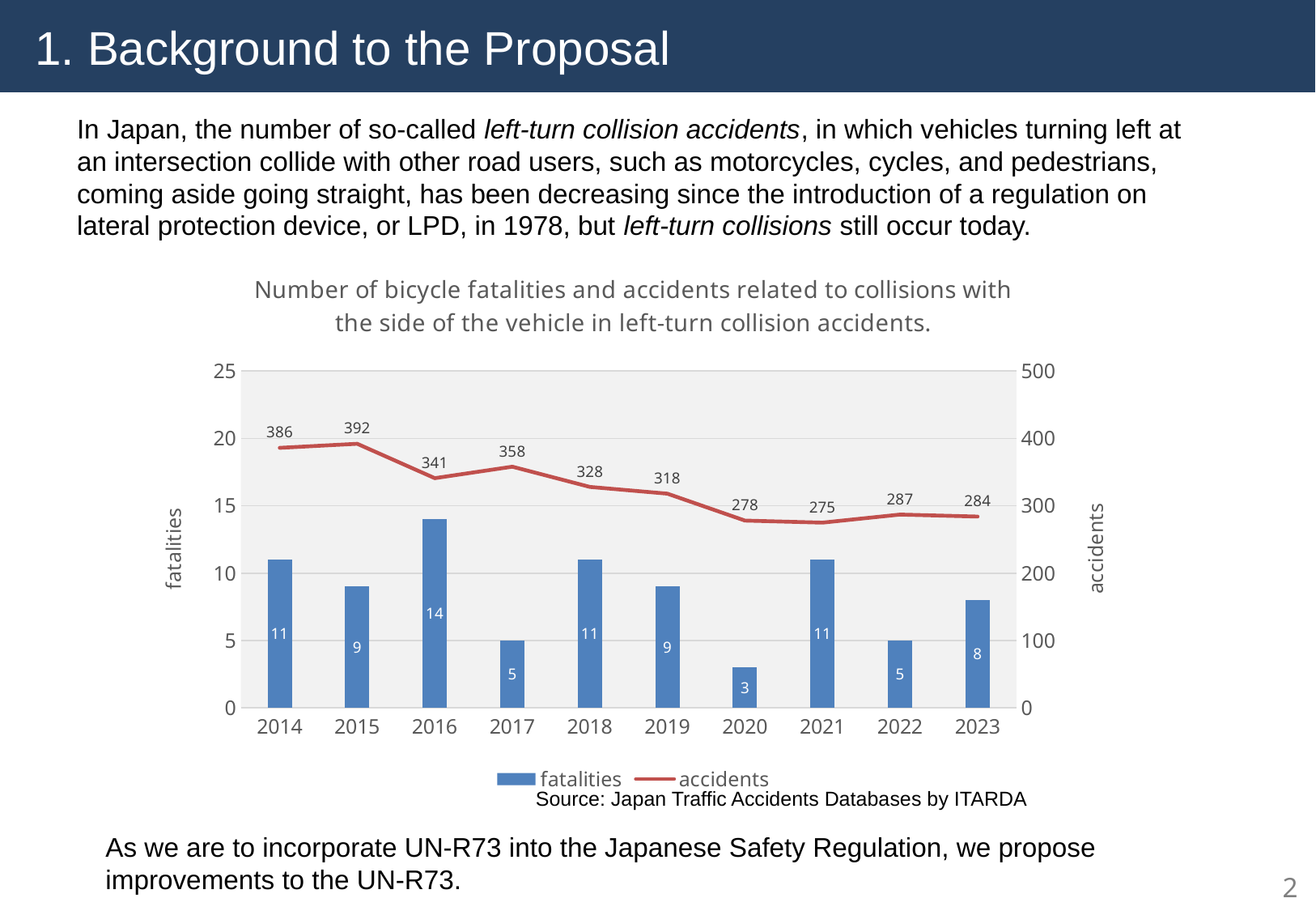
Which year had more fatalities, 2017 or 2023? 2023 Do the accident numbers generally rise or fall from 2014 to 2023? fall What kind of chart is used to show the fatalities series? bar chart What is the label of the right-hand vertical axis? accidents What is the difference in accidents between 2014 and 2023? 102 How many series does the legend list? 2 How many years are shown on the x axis? 10 Which year had the lowest number of fatalities? 2020 What colour is the accidents line? red Which year had the highest number of accidents? 2015 How many accidents were recorded in 2015? 392 How many bicycle fatalities were recorded in 2016? 14